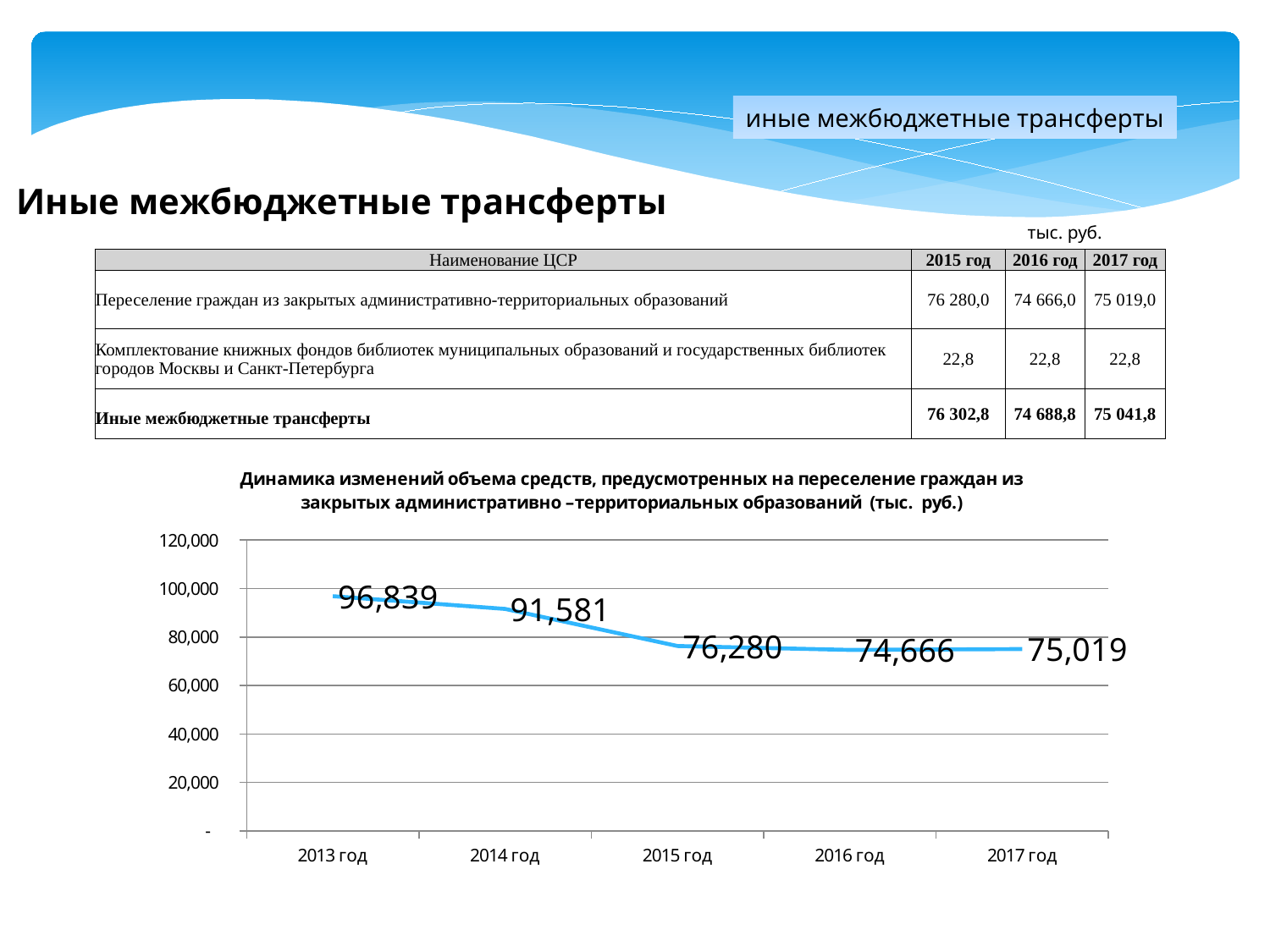
Which year has the lowest value on the line chart? 2016 год Which year has the highest value on the line chart? 2013 год Which is larger on the line chart: the value for 2015 год or 2017 год? 2015 год What is the difference between the values for 2013 год and 2014 год on the line chart? 5,258 What is the value for 2014 год on the line chart? 91,581 What kind of chart is shown on the slide? line chart What is the value for 2017 год on the line chart? 75,019 What is the value for 2016 год on the line chart? 74,666 How many years are plotted on the line chart? 5 What is the value for 2013 год on the line chart? 96,839 Do the values on the line chart generally rise or fall from 2013 год to 2017 год? fall What is the difference between the values for 2014 год and 2015 год on the line chart? 15,301